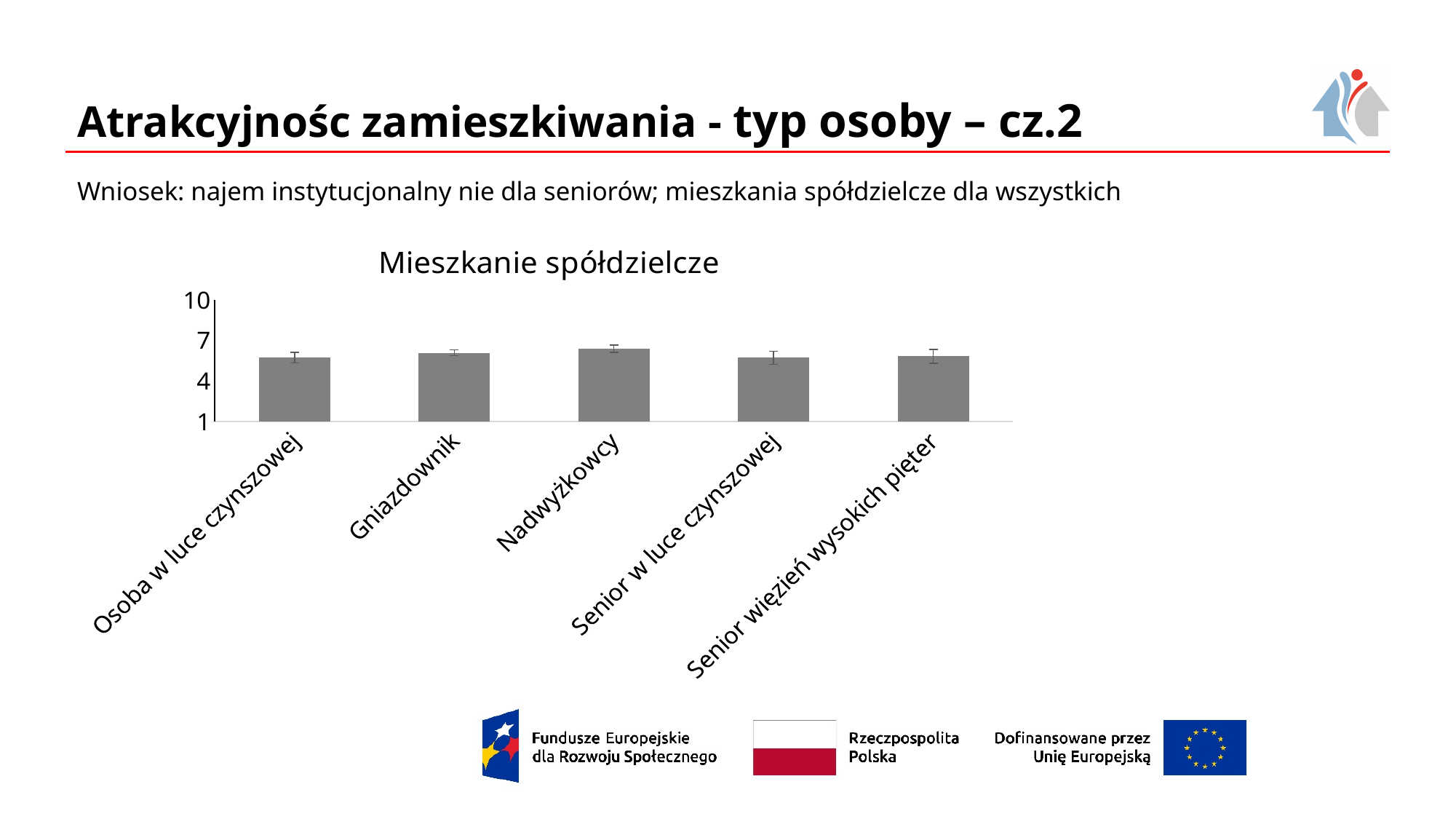
Is the value for Senior więzień wysokich pięter greater or less than 4? greater What is the title of the chart? Mieszkanie spółdzielcze How many categories are shown on the x axis of the chart? 5 Is the value for Nadwyżkowcy greater or less than 4? greater Is the value for Osoba w luce czynszowej greater or less than 7? less Which category has the highest bar in the chart? Nadwyżkowcy Which is larger, the value for Nadwyżkowcy or the value for Senior w luce czynszowej? Nadwyżkowcy What kind of chart is shown on the slide? bar chart What is the highest value shown on the y axis of the chart? 10